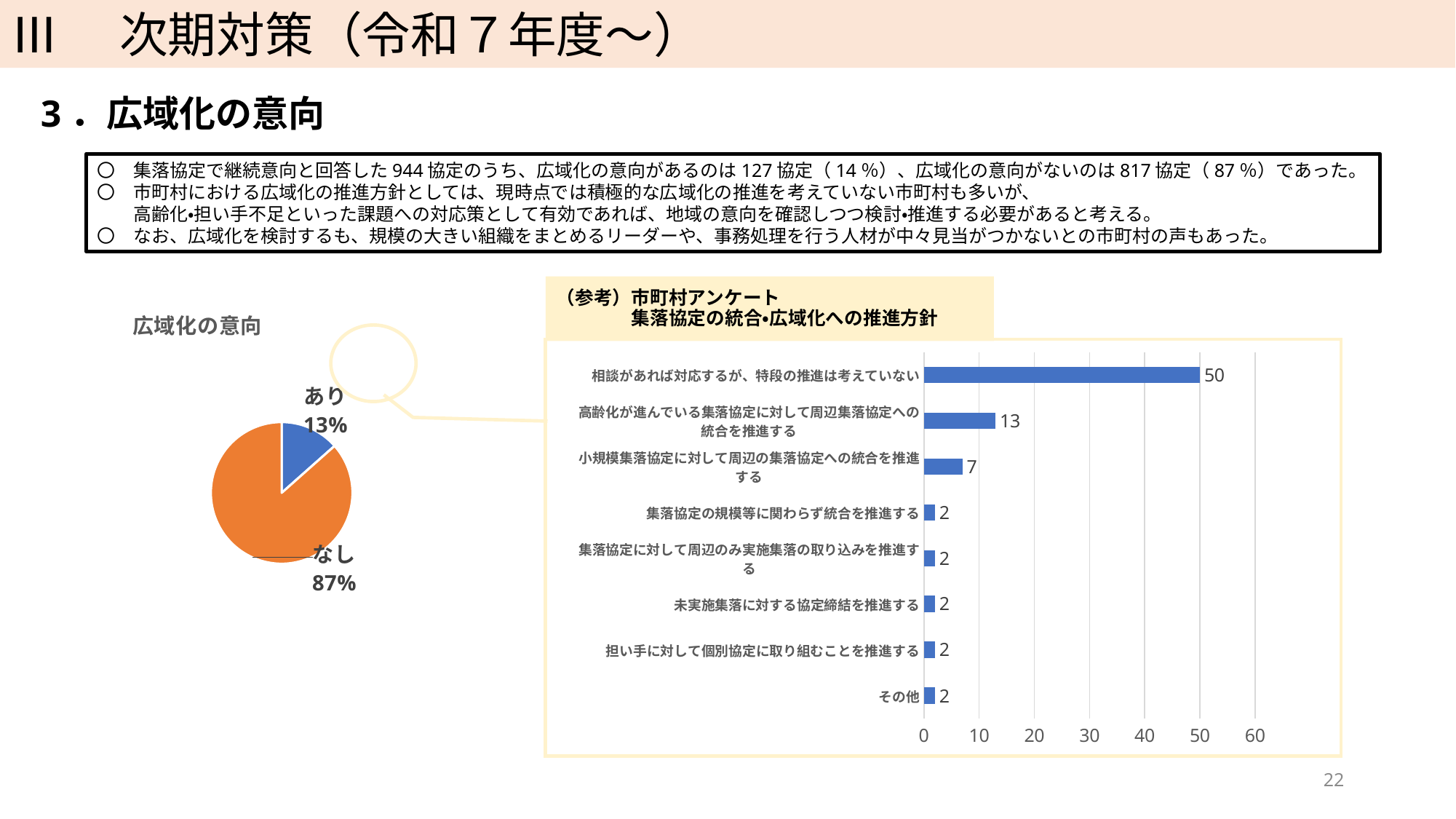
In the pie chart titled 広域化の意向, which slice is larger, あり or なし? なし What kind of chart is the chart titled 広域化の意向? pie chart In the pie chart titled 広域化の意向, what share does なし have? 87% In the pie chart titled 広域化の意向, what share does あり have? 13% In the bar chart on the right (市町村アンケート), what is the value for 高齢化が進んでいる集落協定に対して周辺集落協定への統合を推進する? 13 In the bar chart on the right (市町村アンケート), what is the difference between the values for 相談があれば対応するが、特段の推進は考えていない and 高齢化が進んでいる集落協定に対して周辺集落協定への統合を推進する? 37 In the bar chart on the right (市町村アンケート), which category has the highest value? 相談があれば対応するが、特段の推進は考えていない In the pie chart titled 広域化の意向, how many slices are there? 2 In the bar chart on the right (市町村アンケート), how many categories are shown? 8 In the bar chart on the right (市町村アンケート), what is the value for 相談があれば対応するが、特段の推進は考えていない? 50 In the bar chart on the right (市町村アンケート), what is the value for 小規模集落協定に対して周辺の集落協定への統合を推進する? 7 What kind of chart is the chart on the right (市町村アンケート)? bar chart